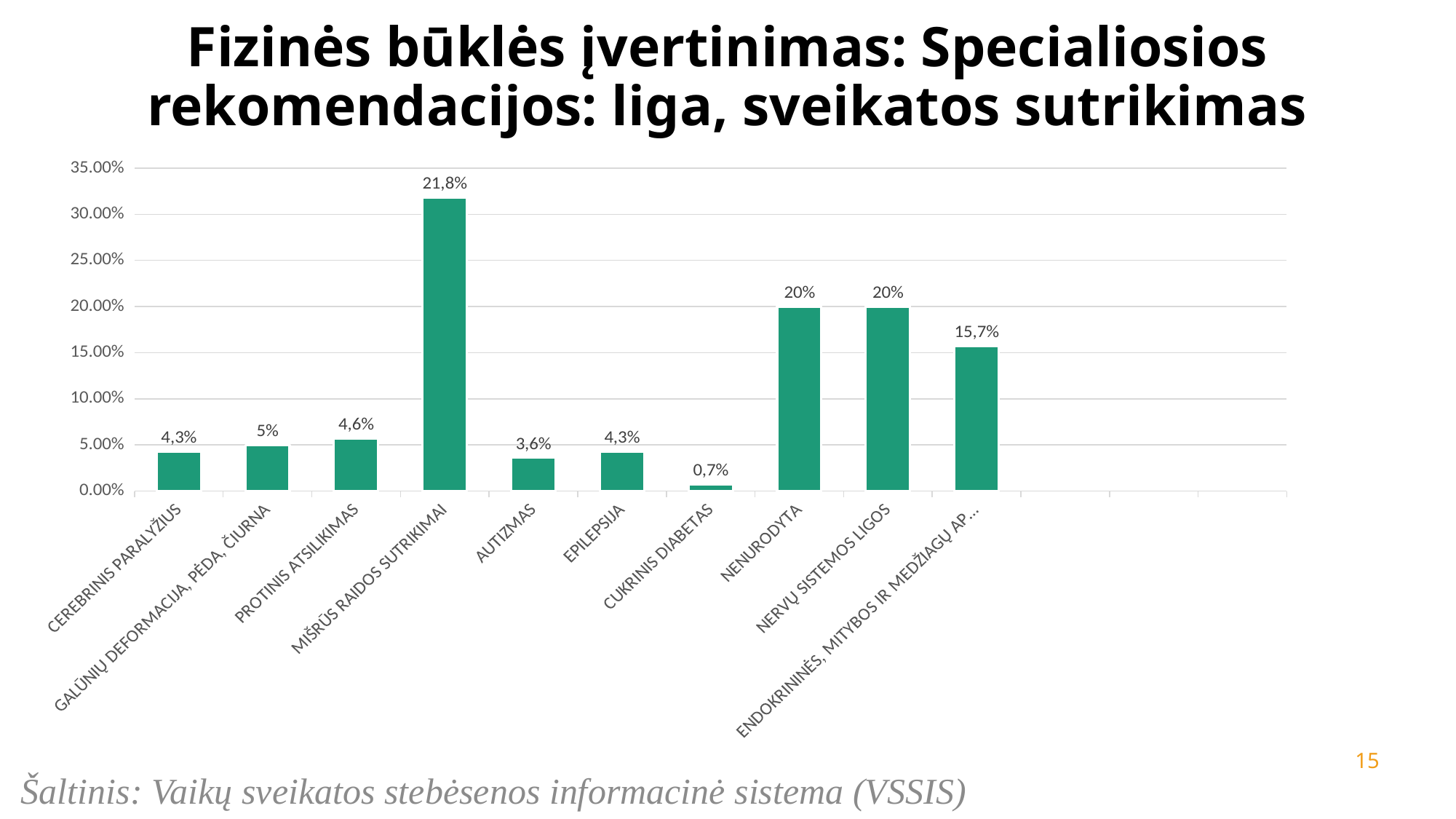
What value is shown for CUKRINIS DIABETAS? 0,7% Which is larger, the value for PROTINIS ATSILIKIMAS or the value for AUTIZMAS? PROTINIS ATSILIKIMAS What value is shown for MIŠRŪS RAIDOS SUTRIKIMAI? 21,8% What value is shown for AUTIZMAS? 3,6% Is the value for NENURODYTA greater or less than 15.00%? greater Which category has the highest value? MIŠRŪS RAIDOS SUTRIKIMAI What is the difference between the values for MIŠRŪS RAIDOS SUTRIKIMAI and NENURODYTA? 1,8% Which category has the lowest value? CUKRINIS DIABETAS What is the difference between the values for GALŪNIŲ DEFORMACIJA, PĖDA, ČIURNA and CEREBRINIS PARALYŽIUS? 0,7% What value is shown for NERVŲ SISTEMOS LIGOS? 20% How many categories are shown on the x axis? 10 What kind of chart is shown on the slide? bar chart